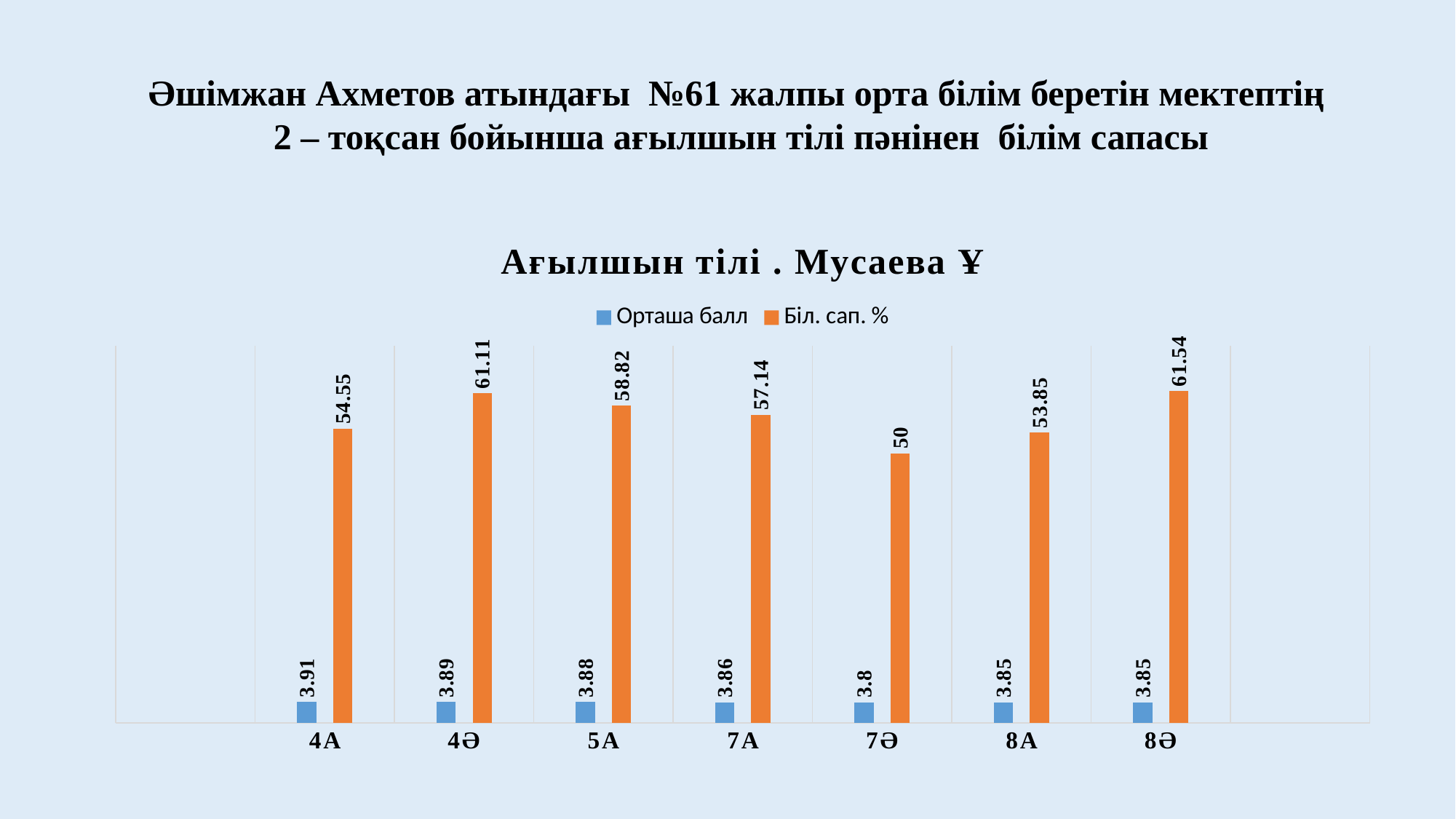
Which class has the highest Орташа балл value? 4А What is the Біл. сап. % value for 4Ә? 61.11 What is the Орташа балл value for 7Ә? 3.8 Which class has the highest Біл. сап. % value? 8Ә What is the Біл. сап. % value for 8А? 53.85 Which is larger, the Біл. сап. % value for 5А or for 7А? 5А How many classes are shown on the x axis? 7 What is the title of the chart? Ағылшын тілі . Мусаева Ұ What is the difference between the Біл. сап. % values for 8Ә and 7Ә? 11.54 What kind of chart is shown? bar chart Which class has the lowest Біл. сап. % value? 7Ә How many series does the legend list? 2